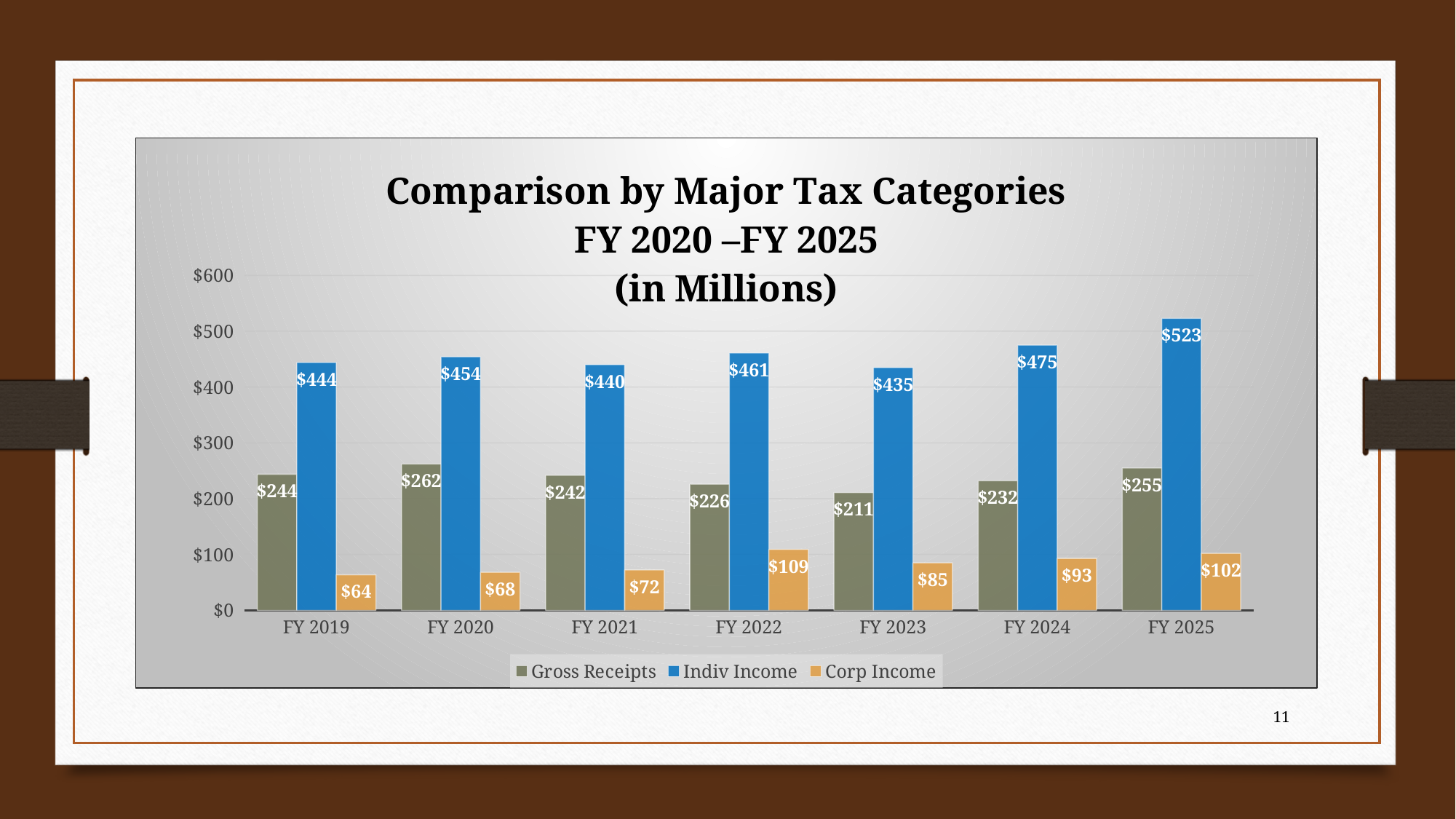
Is the Indiv Income value for FY 2025 greater or less than $500? greater Which fiscal year has the highest Indiv Income value? FY 2025 Which is larger, the Gross Receipts value for FY 2020 or for FY 2025? FY 2020 How many series does the legend list? 3 What is the Indiv Income value for FY 2022? $461 Which series is shown in blue in the legend? Indiv Income What is the Gross Receipts value for FY 2023? $211 What kind of chart is shown on the slide? bar chart What is the Corp Income value for FY 2021? $72 How many fiscal years are shown on the x axis? 7 Which fiscal year has the lowest Corp Income value? FY 2019 What is the difference between the Indiv Income values for FY 2025 and FY 2024? $48